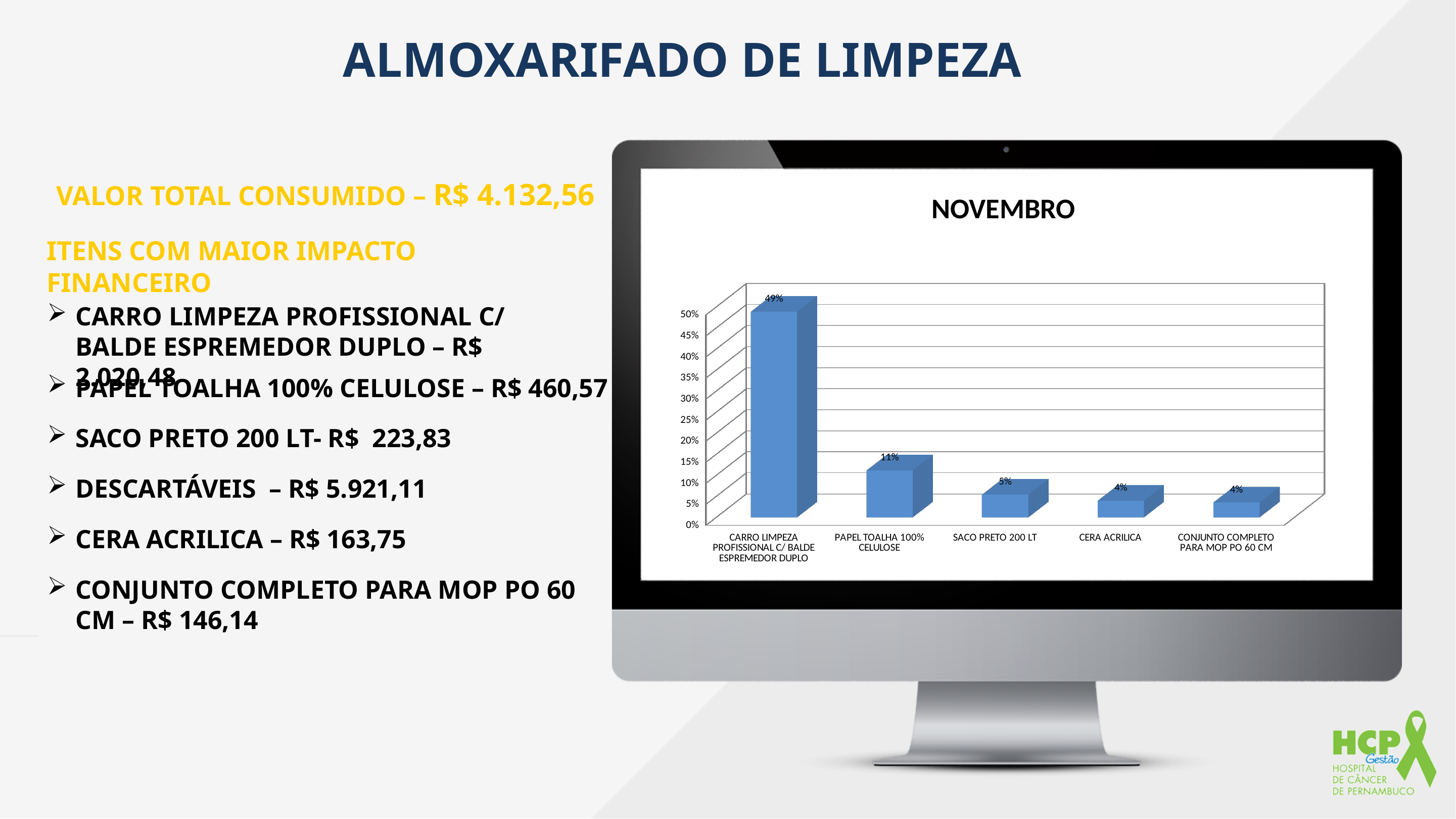
What kind of chart is shown on the slide? bar chart Is the value for CARRO LIMPEZA PROFISSIONAL C/ BALDE ESPREMEDOR DUPLO greater or less than 45%? greater Which category has the highest value? CARRO LIMPEZA PROFISSIONAL C/ BALDE ESPREMEDOR DUPLO How many categories are plotted in the chart? 5 What is the title of the chart? NOVEMBRO Do the values rise or fall from left to right along the x axis? fall What is the value for SACO PRETO 200 LT? 5% What is the value for CERA ACRILICA? 4% What is the value for PAPEL TOALHA 100% CELULOSE? 11% What is the value for CARRO LIMPEZA PROFISSIONAL C/ BALDE ESPREMEDOR DUPLO? 49% Which is larger, the value for PAPEL TOALHA 100% CELULOSE or the value for SACO PRETO 200 LT? PAPEL TOALHA 100% CELULOSE What is the difference between the values for CARRO LIMPEZA PROFISSIONAL C/ BALDE ESPREMEDOR DUPLO and PAPEL TOALHA 100% CELULOSE? 38%